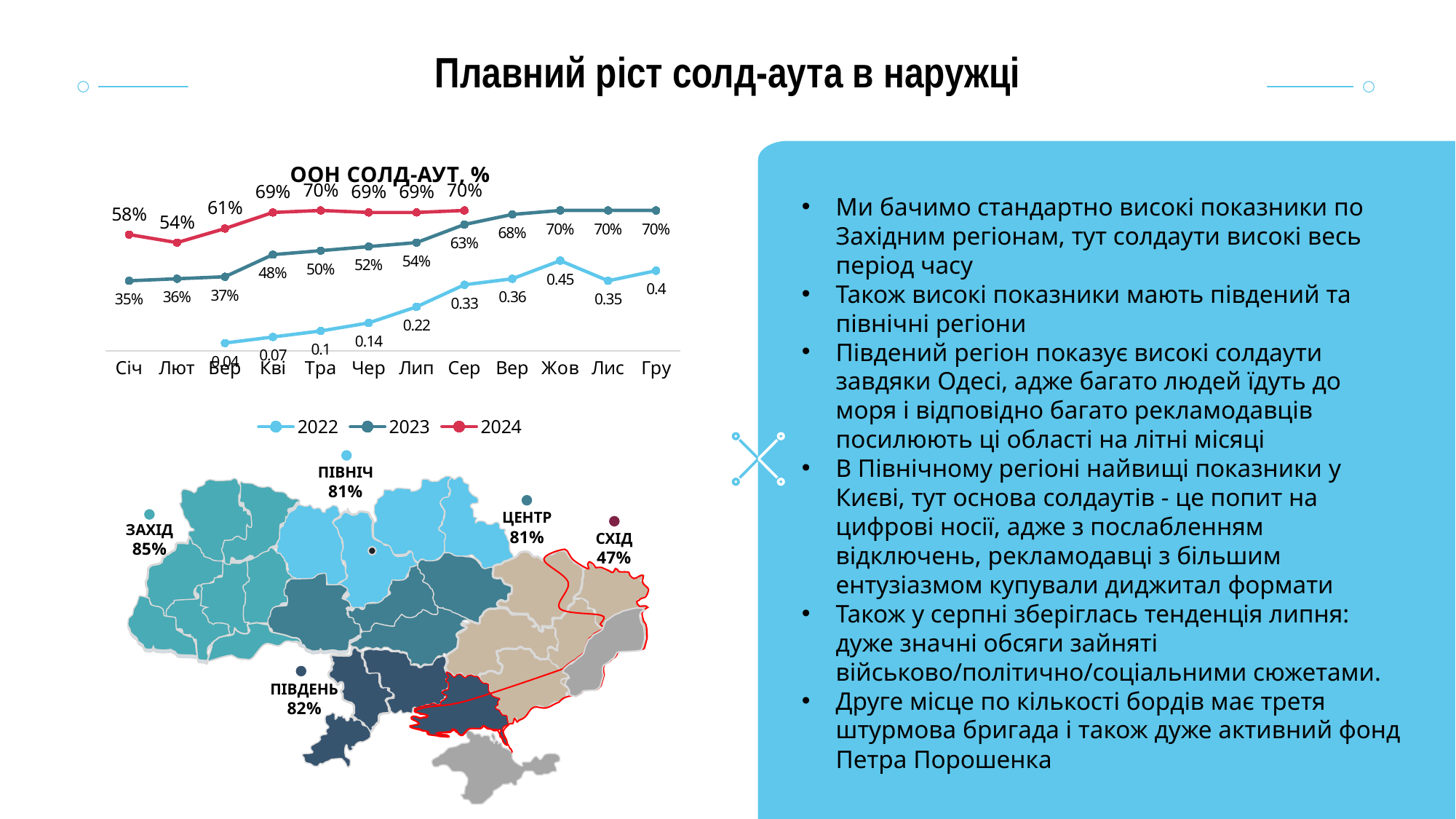
In the line chart ООН СОЛД-АУТ, %, what is the value for 2022 in Жов? 0.45 On the map of Ukraine below the line chart, what percentage is shown for the ЗАХІД region? 85% In the line chart ООН СОЛД-АУТ, %, does the 2023 series rise or fall from Січ to Гру? Rises In the line chart ООН СОЛД-АУТ, %, how many months are shown on the x axis? 12 In the line chart ООН СОЛД-АУТ, %, what is the value for 2023 in Сер? 63% In the line chart ООН СОЛД-АУТ, %, by how much does the 2023 value in Гру exceed the 2023 value in Січ? 35% In the line chart ООН СОЛД-АУТ, %, in which month does the 2024 series have its lowest value? Лют In the line chart ООН СОЛД-АУТ, %, what is the value for 2024 in Січ? 58% In the line chart ООН СОЛД-АУТ, %, how many series does the legend list? 3 In the line chart ООН СОЛД-АУТ, %, in which month does the 2022 series reach its highest value? Жов What type of chart is ООН СОЛД-АУТ, %? Line chart In the line chart ООН СОЛД-АУТ, %, which series has the higher value in Бер, 2023 or 2024? 2024